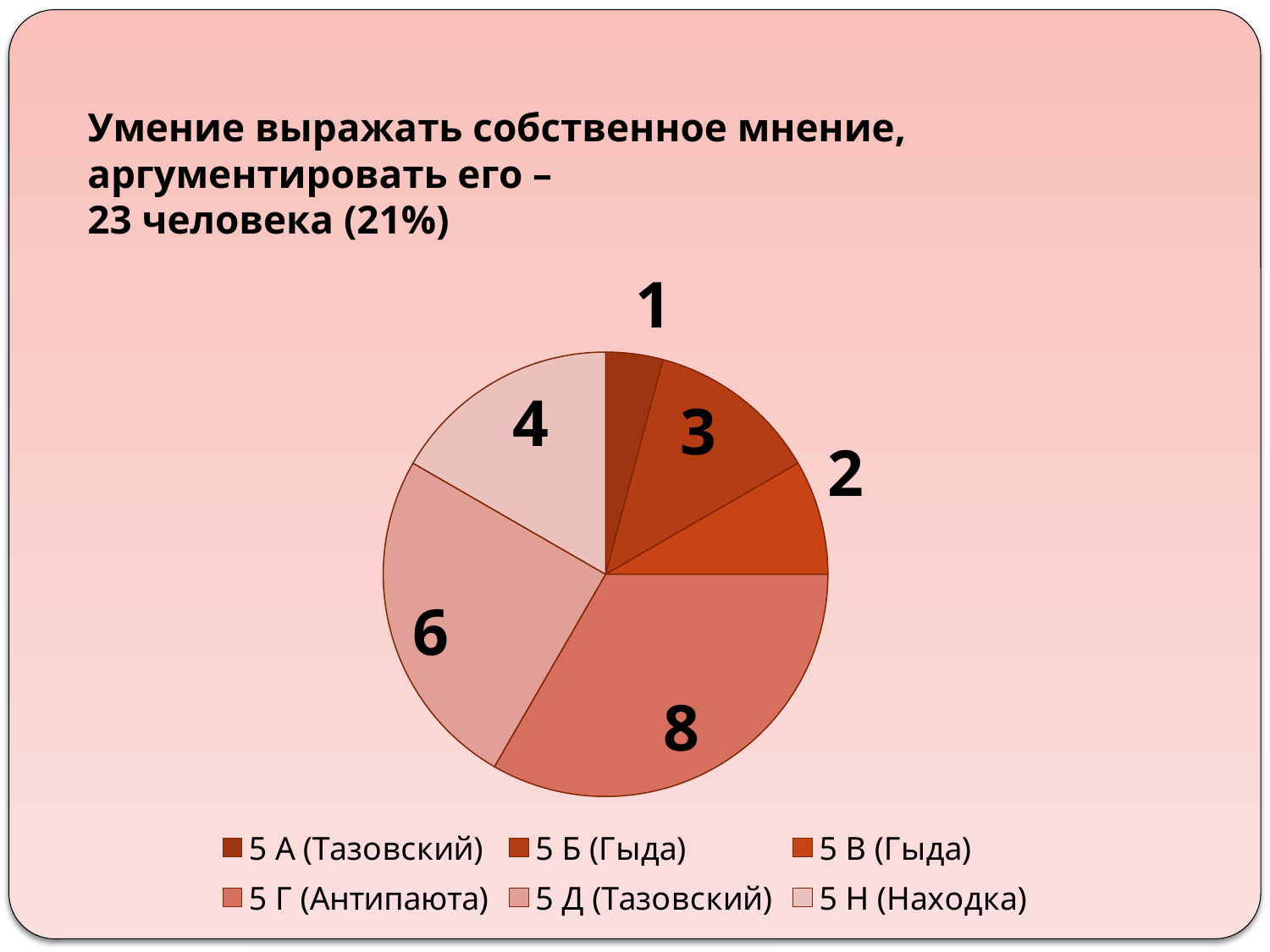
What type of chart is shown on the slide? pie chart What is the value for 5 Д (Тазовский)? 6 Which category has the largest slice? 5 Г (Антипаюта) What is the value for 5 А (Тазовский)? 1 Which category has the smallest slice? 5 А (Тазовский) What is the value for 5 Г (Антипаюта)? 8 What is the title of the chart? Умение выражать собственное мнение, аргументировать его – 23 человека (21%) Which is larger, the value for 5 Б (Гыда) or the value for 5 В (Гыда)? 5 Б (Гыда) What is the difference between the values for 5 Г (Антипаюта) and 5 Д (Тазовский)? 2 How many categories does the legend list? 6 What is the value for 5 Н (Находка)? 4 What is the value for 5 Б (Гыда)? 3